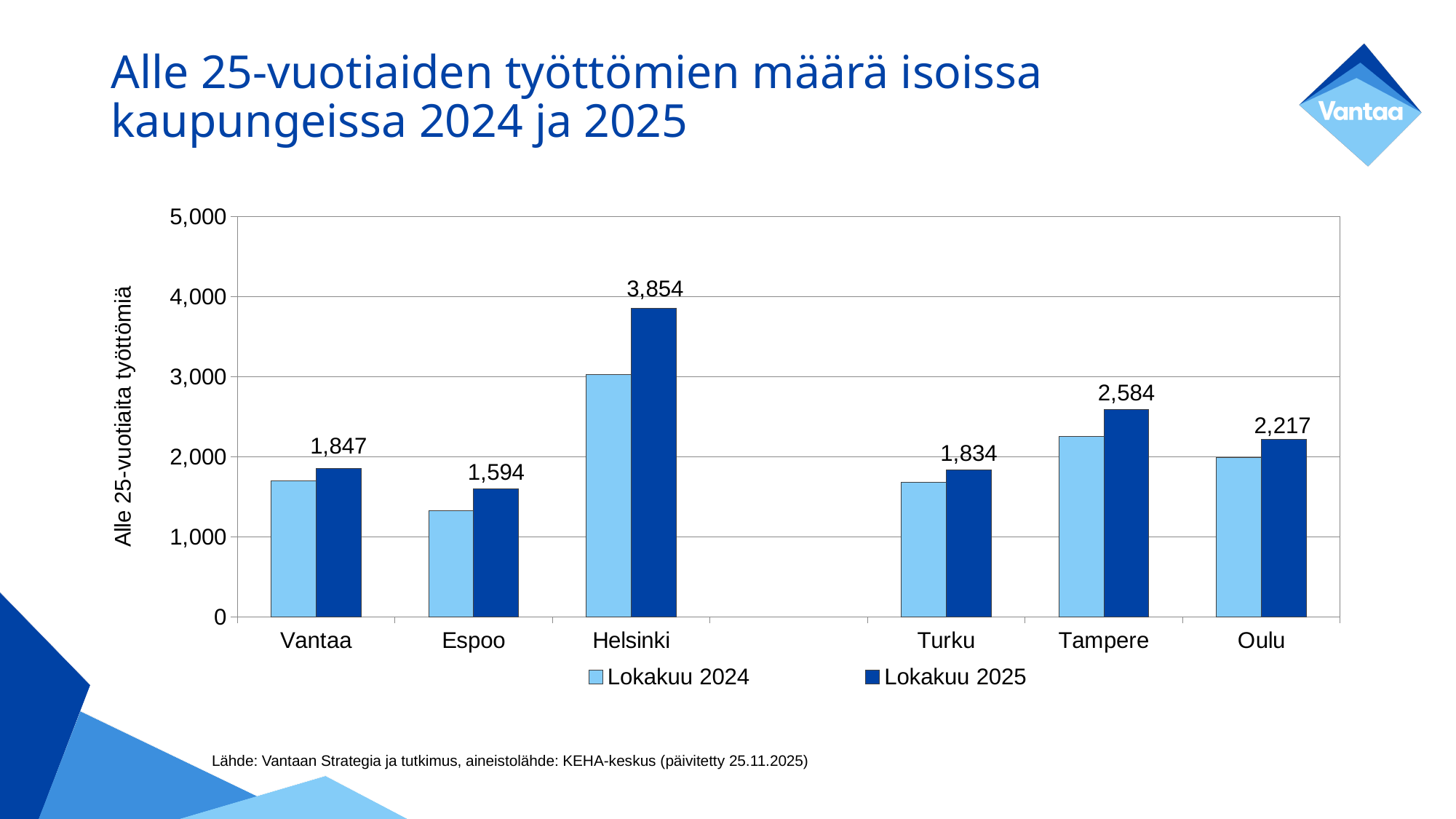
What is the difference between the Lokakuu 2025 values for Helsinki and Tampere? 1,270 Is the Lokakuu 2024 value for Vantaa greater or less than 2,000? less How many cities are shown on the x axis? 6 Which city has the highest Lokakuu 2025 value? Helsinki What is the Lokakuu 2025 value for Helsinki? 3,854 What is the Lokakuu 2025 value for Tampere? 2,584 Is the Lokakuu 2024 value for Tampere greater or less than 2,000? greater What is the Lokakuu 2025 value for Espoo? 1,594 Which is larger, the Lokakuu 2025 value for Vantaa or for Turku? Vantaa How many series does the legend list? 2 What is the difference between the Lokakuu 2025 values for Oulu and Turku? 383 Which city has the lowest Lokakuu 2025 value? Espoo